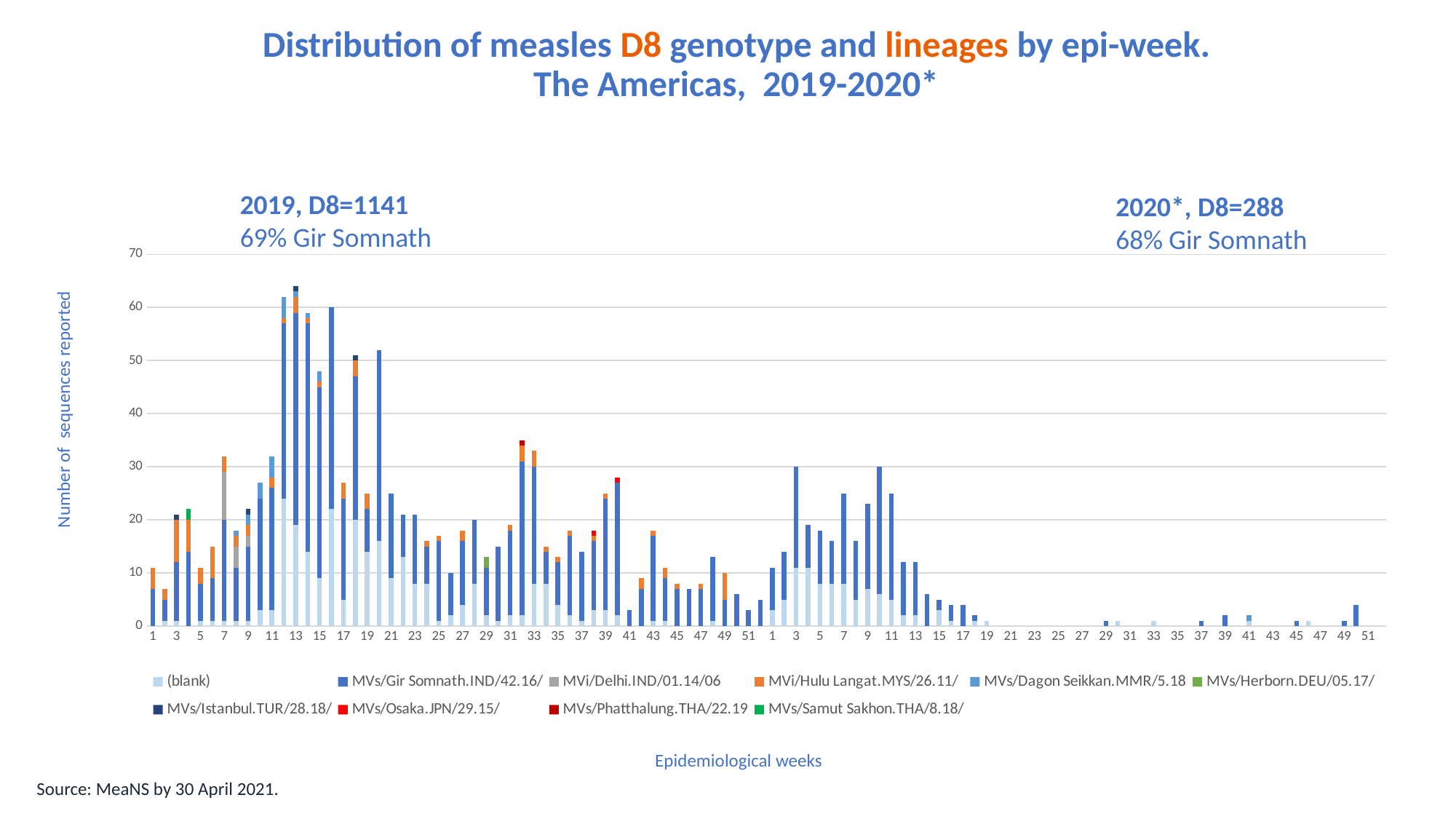
Which bar is taller: epi-week 13 of 2019 or epi-week 3 of 2020? epi-week 13 of 2019 What percentage of 2020* D8 sequences were Gir Somnath, according to the annotation? 68% How many series does the legend list? 10 Is the total number of sequences reported in epi-week 7 of 2020 greater or less than 20? greater Is the total number of sequences reported in epi-week 13 of 2019 greater or less than 60? greater What kind of chart is shown on the slide? bar chart Is the total number of sequences reported in epi-week 40 of 2019 greater or less than 30? less What percentage of 2019 D8 sequences were Gir Somnath, according to the annotation? 69% Do the bar totals rise or fall from epi-week 11 to epi-week 19 of 2020? fall According to the annotation, how many D8 sequences were reported in 2020*? 288 According to the annotation, how many D8 sequences were reported in 2019? 1141 What is the title of the vertical axis? Number of sequences reported